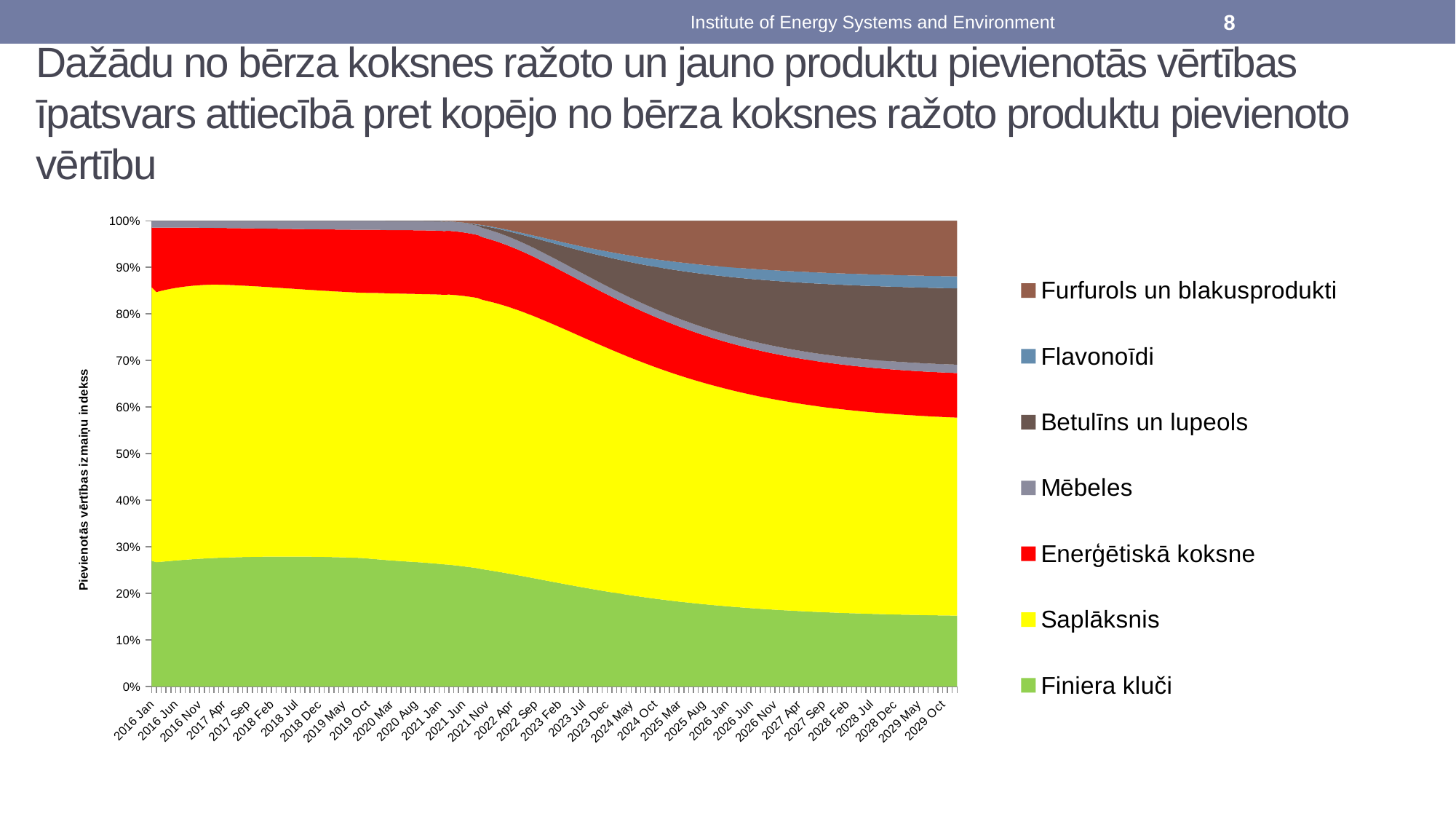
What is the label of the vertical axis? Pievienotās vērtības izmaiņu indekss Is the share of Finiera kluči at 2016 Jan greater or less than 20%? greater Which series has the largest share at 2029 Oct? Saplāksnis What kind of chart is shown on the slide? Stacked area chart Which series has the largest share at 2016 Jan? Saplāksnis Does the share of Finiera kluči rise or fall from 2016 Jan to 2029 Oct? Fall Is the share of Finiera kluči at 2029 Oct greater or less than 20%? less Which series is listed at the bottom of the legend? Finiera kluči Does the share of Furfurols un blakusprodukti rise or fall from 2021 to 2029 Oct? Rise Does the share of Saplāksnis rise or fall from 2021 to 2029 Oct? Fall At 2016 Jan, which has the larger share: Saplāksnis or Enerģētiskā koksne? Saplāksnis How many series does the legend list? 7